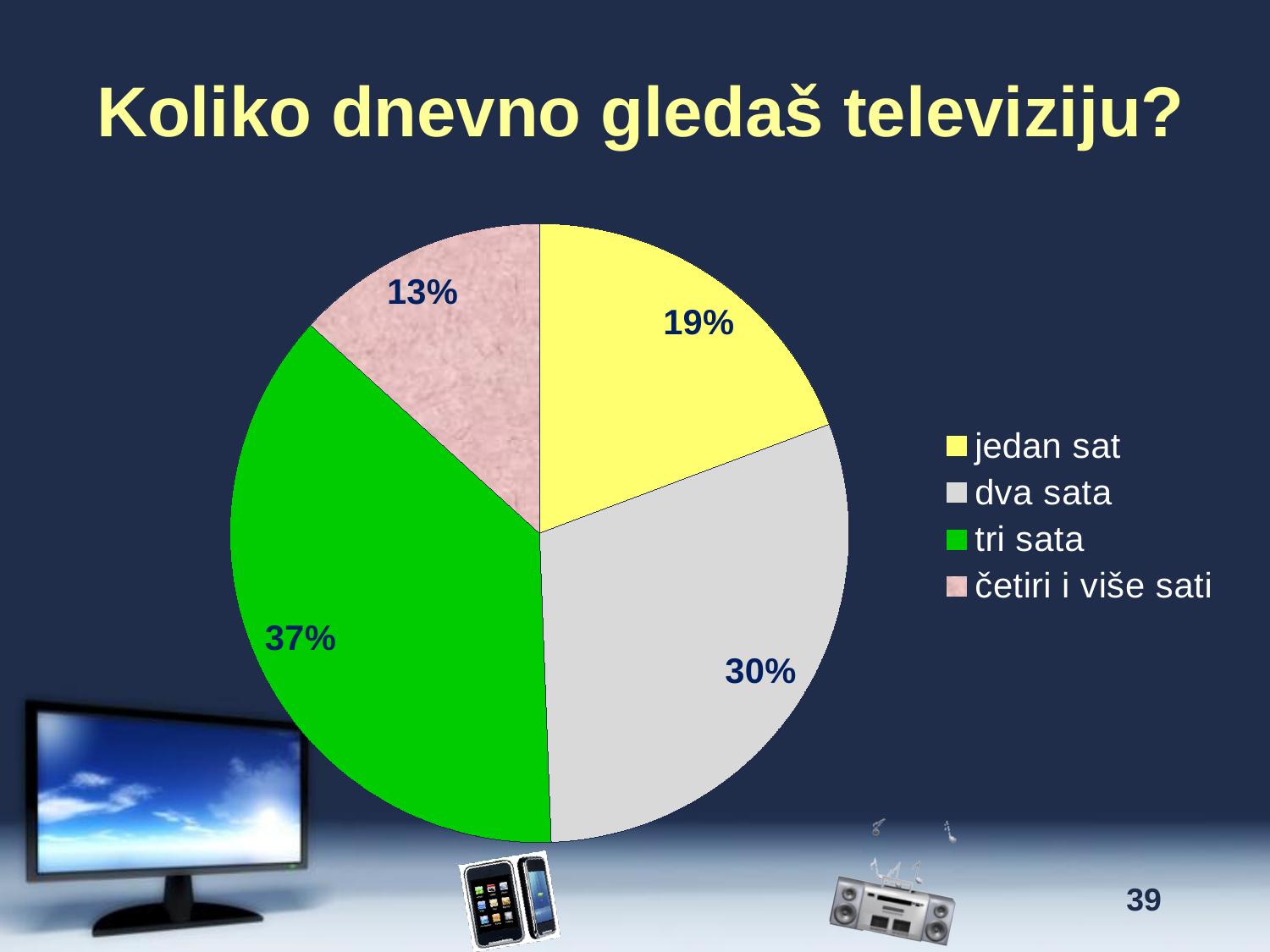
How many categories does the pie chart show? 4 What is the title of the slide containing the chart? Koliko dnevno gledaš televiziju? Which category has the smallest slice of the pie? četiri i više sati What kind of chart is shown on the slide? pie chart What is the difference in percentage points between "dva sata" and "četiri i više sati"? 17 What share of the pie does "dva sata" represent? 30% What share of the pie does "četiri i više sati" represent? 13% Which is larger, the slice for "dva sata" or the slice for "jedan sat"? dva sata Which category has the largest slice of the pie? tri sata What share of the pie does "tri sata" represent? 37% What is the difference in percentage points between "tri sata" and "jedan sat"? 18